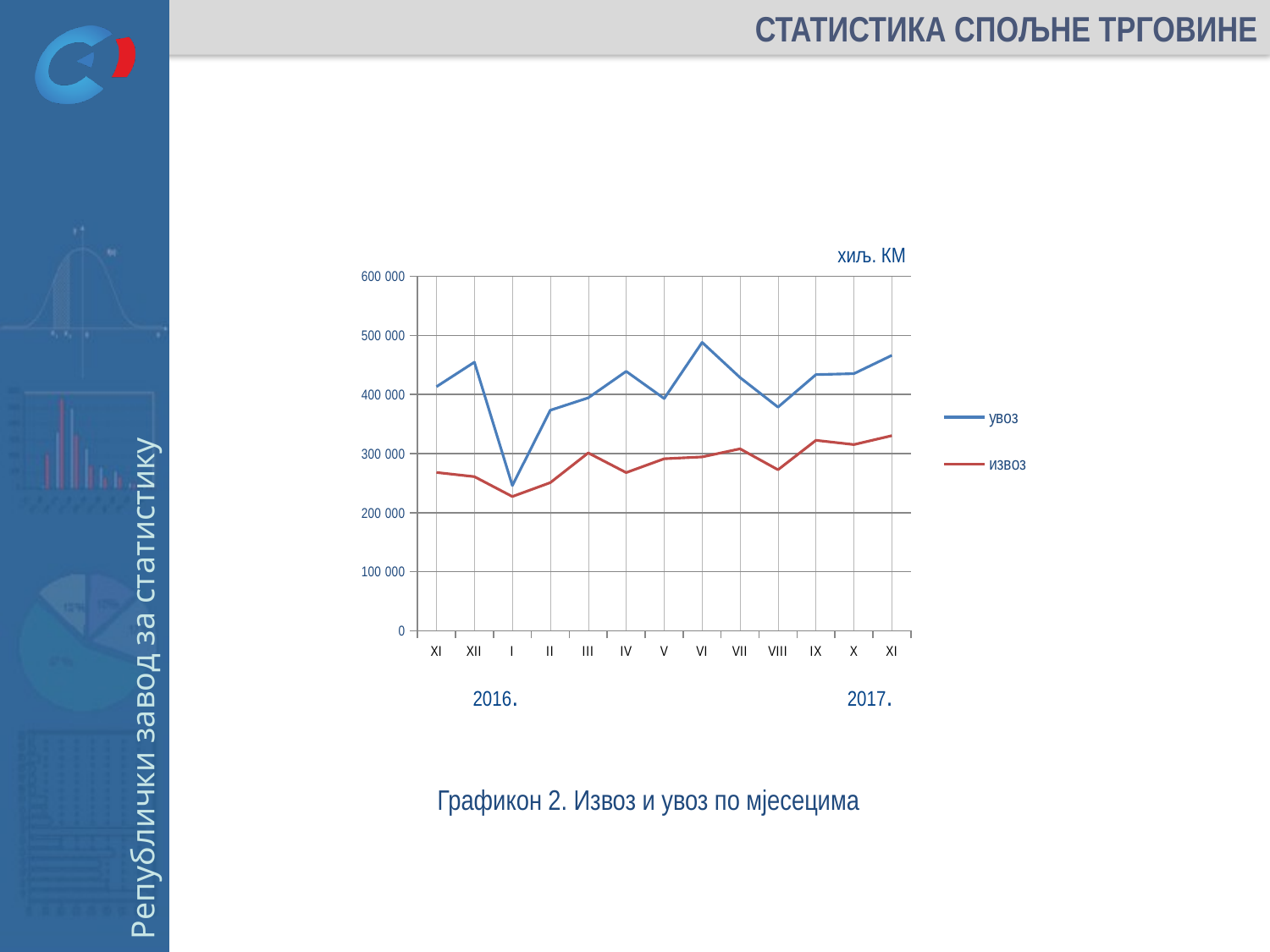
In which month does the извоз series reach its lowest value? I (2017) Is the value of увоз in month VI (2017) greater or less than 400 000? greater Is the value of увоз in month I (2017) greater or less than 300 000? less What kind of chart is shown on the slide? line chart Is the value of извоз in month XI (2017) greater or less than 300 000? greater Which series has the larger value in month XII (2016), увоз or извоз? увоз In which month does the увоз series reach its lowest value? I (2017) In which month does the увоз series reach its highest value? VI (2017) How many months are plotted along the x axis? 13 What unit is indicated above the chart? хиљ. КМ Does the увоз series rise or fall from month I to month IV of 2017? rise How many series does the legend list? 2